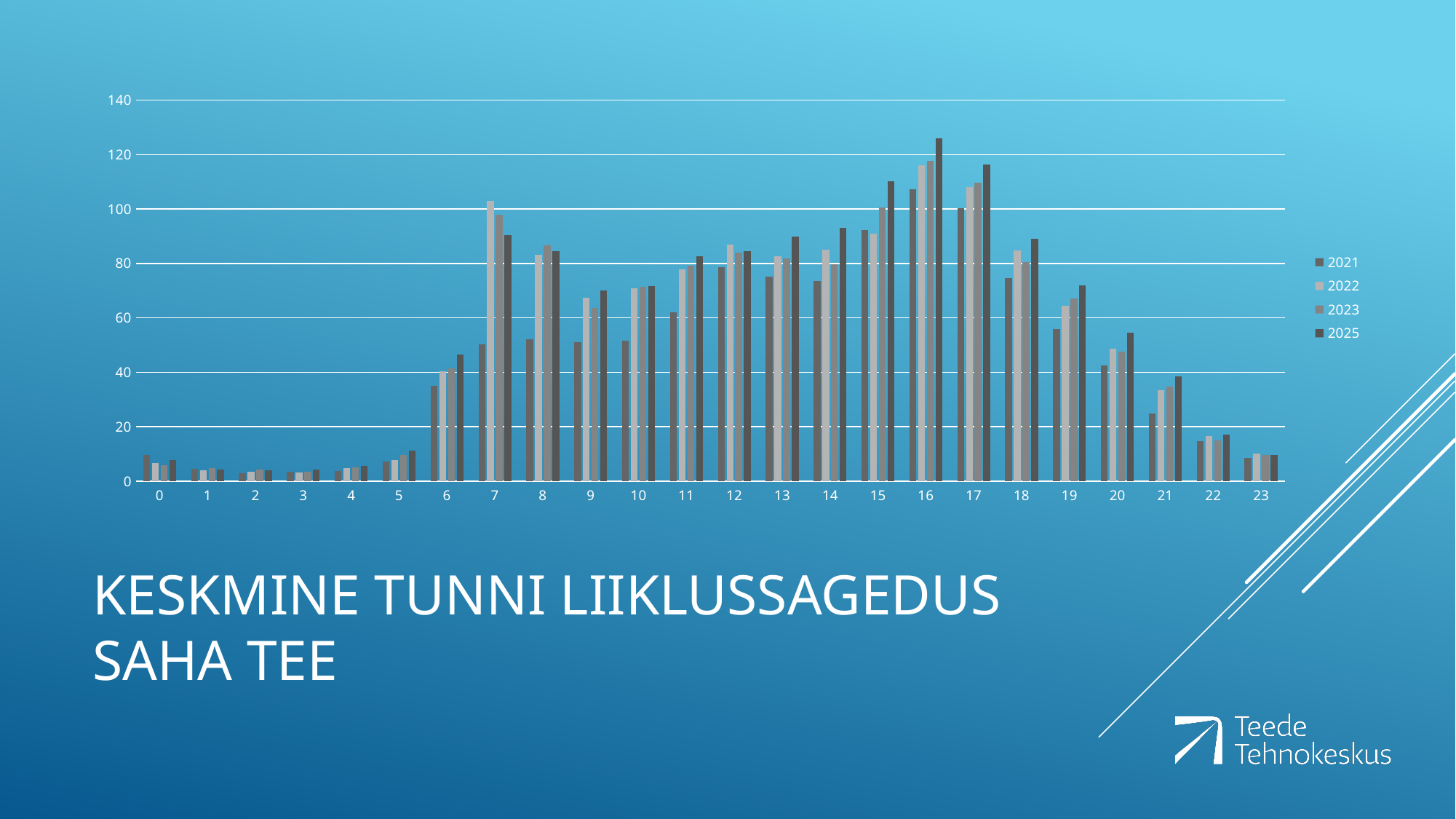
At which hour does the 2025 series reach its highest value? 16 What kind of chart is shown on the slide? bar chart How many series does the legend list? 4 At hour 7, which is larger: the value for 2022 or the value for 2025? 2022 How many hour categories are shown on the x axis? 24 Is the value for 2021 at hour 6 greater or less than 40? less Is the value for 2022 at hour 7 greater or less than 100? greater Which years are listed in the legend? 2021, 2022, 2023, 2025 Is the value for 2025 at hour 16 greater or less than 120? greater Which series has the highest value at hour 16? 2025 What is the title of the slide containing the chart? KESKMINE TUNNI LIIKLUSSAGEDUS SAHA TEE Do the 2025 values rise or fall from hour 17 to hour 23? fall